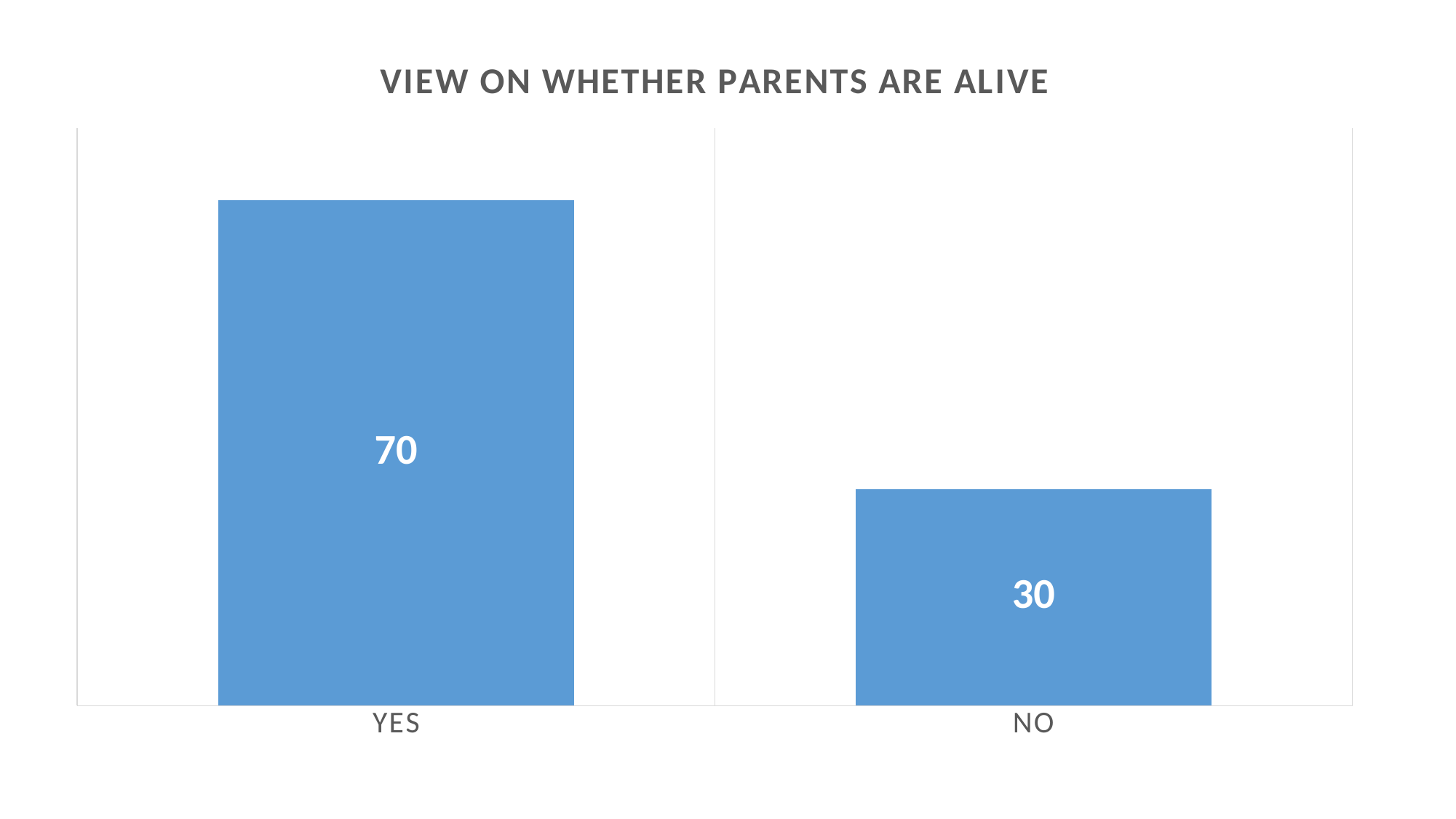
What is the value for YES? 70 What colour are the bars in the chart? Blue Which is larger, the value for YES or the value for NO? YES Which category has the highest value? YES What is the title of the chart? VIEW ON WHETHER PARENTS ARE ALIVE What kind of chart is shown on the slide? Bar chart How many categories are shown in the chart? 2 Which category has the lowest value? NO Do the values rise or fall from YES to NO? Fall What is the difference between the values for YES and NO? 40 What is the value for NO? 30